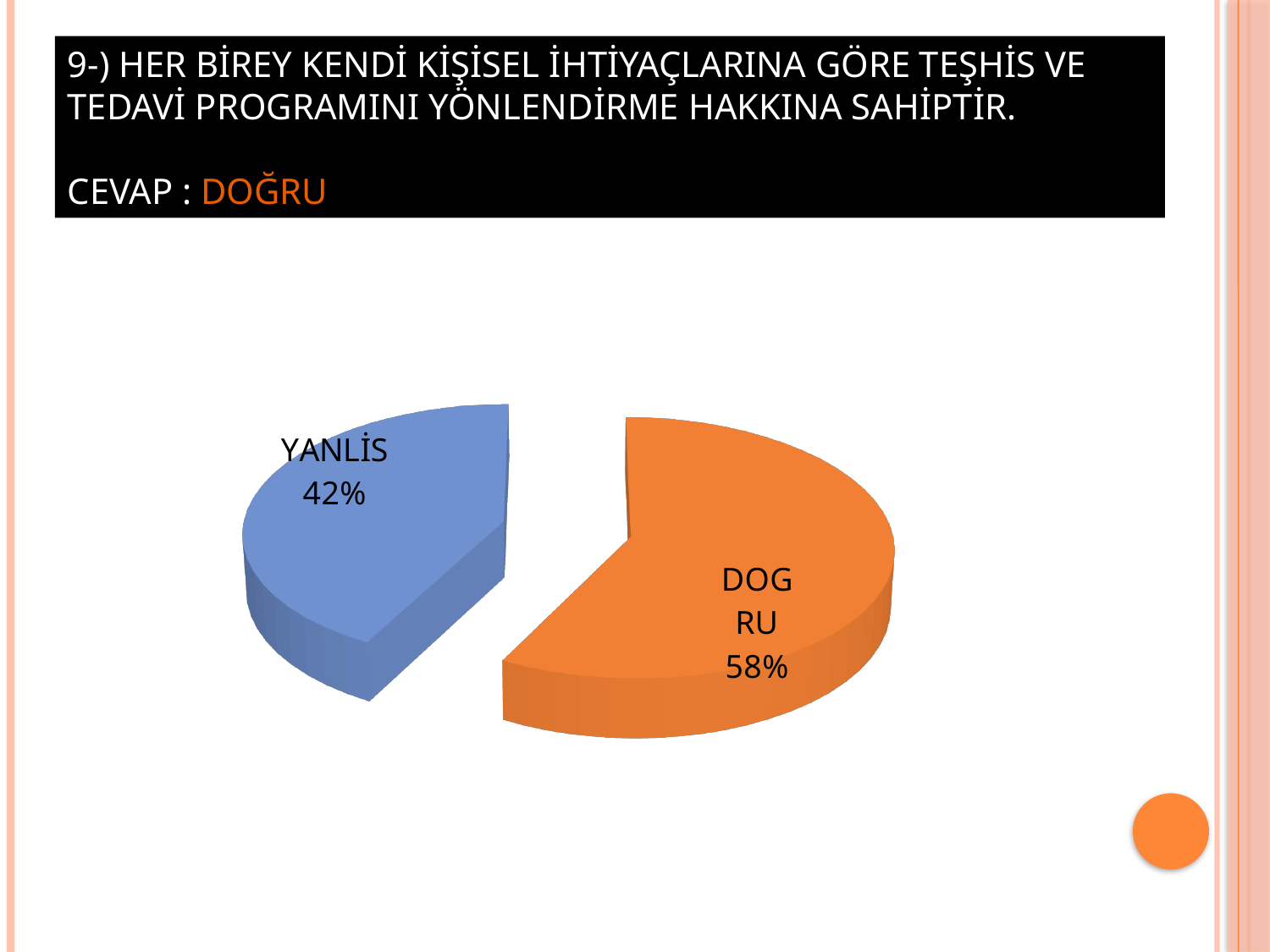
What kind of chart is shown on the slide? Pie chart What colour is the DOGRU slice of the pie chart? Orange Which slice of the pie chart is the largest? DOGRU What percentage of the pie chart is labelled DOGRU? 58% What colour is the YANLİS slice of the pie chart? Blue What percentage of the pie chart is labelled YANLİS? 42% Which slice of the pie chart is the smallest? YANLİS What share of the pie does the YANLİS slice represent? 42% What is the difference in percentage points between the DOGRU and YANLİS slices? 16 Which slice is larger, DOGRU or YANLİS? DOGRU How many slices does the pie chart have? 2